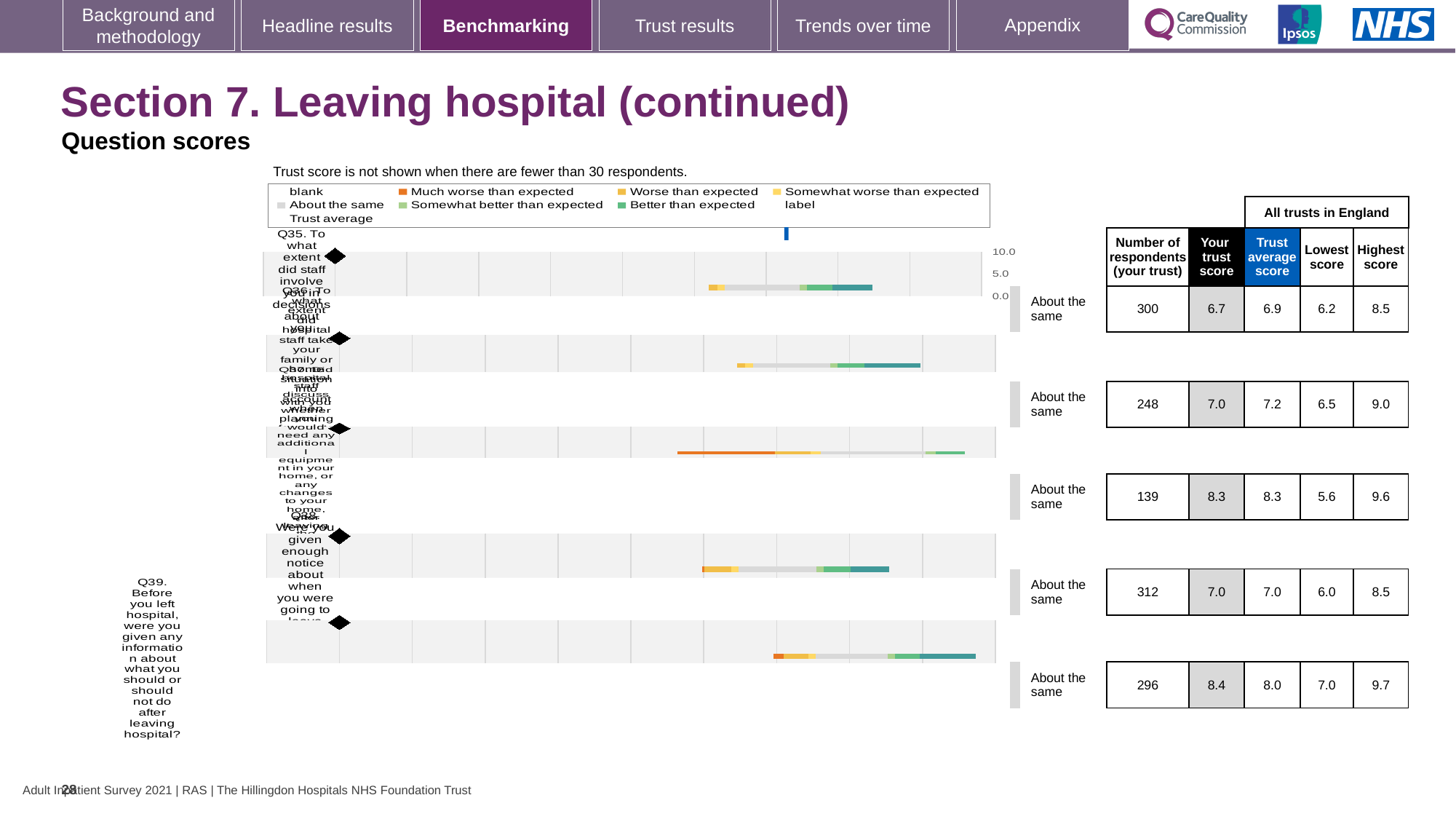
What is the lowest score across all trusts in England for Q38 (were you given enough notice about when you were going to leave)? 6.0 What benchmark category is shown for Q35? About the same For Q39, what is the difference between the trust's score and the trust average score? 0.4 How many questions are shown on this slide? 5 What is the highest score across all trusts in England for Q39? 9.7 How many respondents does the table show for Q39 (information about what you should or should not do after leaving hospital)? 296 What kind of chart is used to show the benchmarking results? Bar chart For Q39, which is larger: the trust's score or the trust average score? Your trust score Which question has the highest 'Highest score' value in the table? Q39 What is the trust average score for Q36? 7.2 Which question has the largest number of respondents? Q38 What is the trust's score for Q35 (to what extent did staff involve you in decisions about you leaving hospital)? 6.7